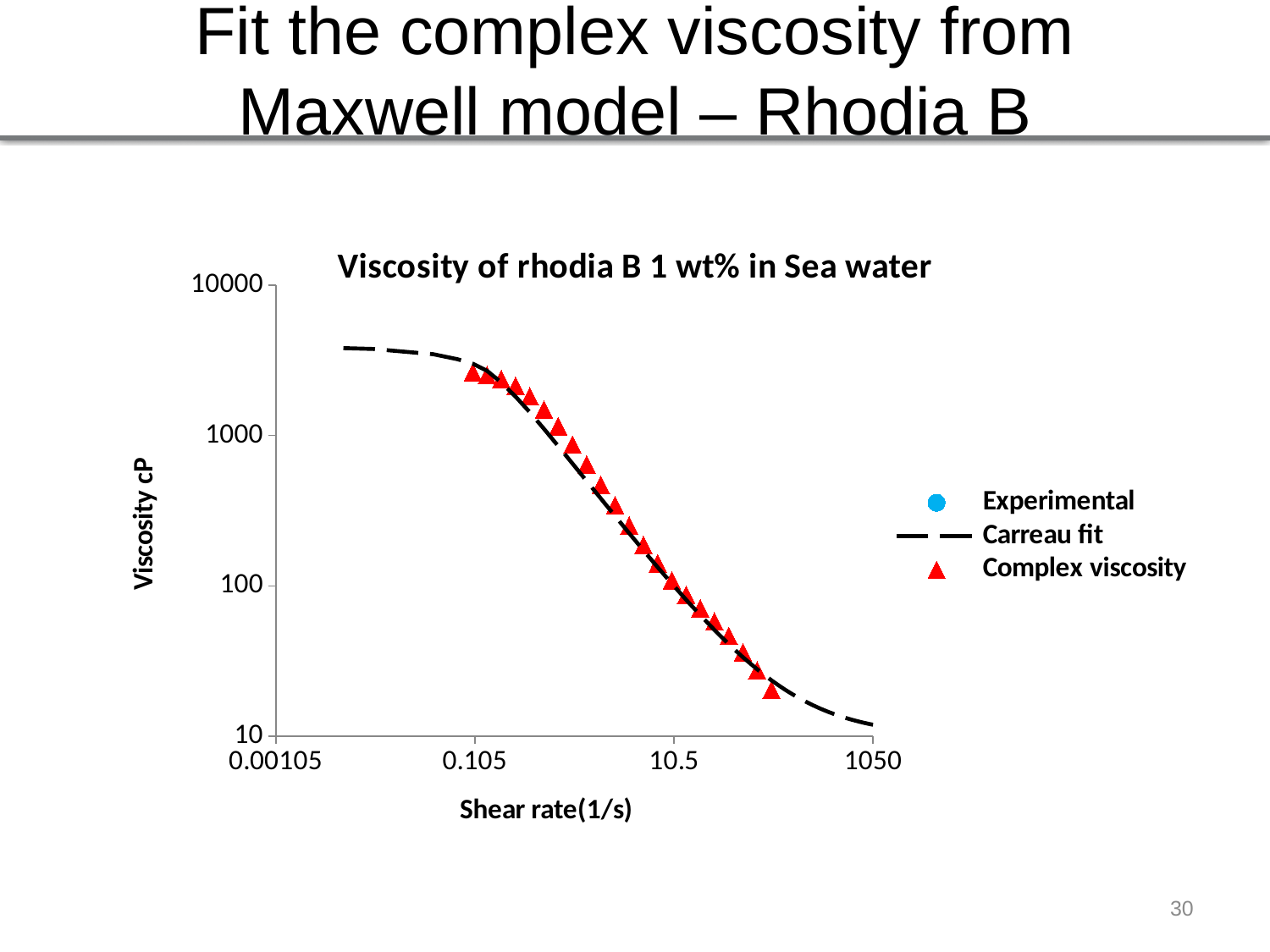
What is the title of the chart? Viscosity of rhodia B 1 wt% in Sea water What kind of chart is shown on the slide? Scatter chart with a fitted line Which series is drawn as a dashed line? Carreau fit Is the lowest Complex viscosity value plotted greater or less than 100? less Does the Complex viscosity rise or fall as shear rate increases along the x axis? Fall Is the Carreau fit value at a shear rate of 0.105 greater or less than 1000? greater Is the highest Complex viscosity value plotted greater or less than 10000? less How many series does the legend list? 3 Does the Carreau fit curve rise or fall as shear rate increases? Fall